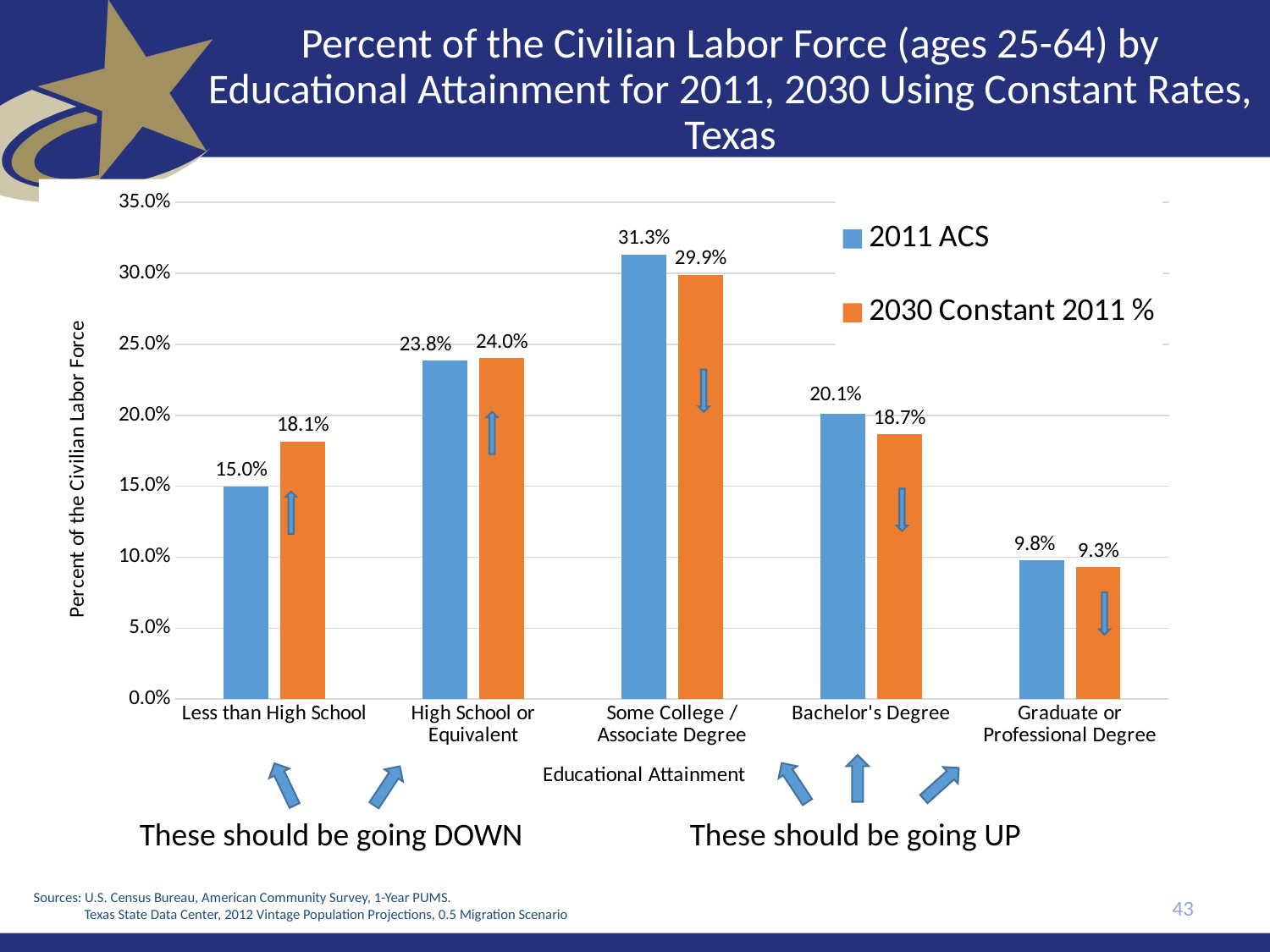
Is the 2011 ACS value for High School or Equivalent greater or less than 25.0%? less For Bachelor's Degree, which is larger: the 2011 ACS value or the 2030 Constant 2011 % value? 2011 ACS What is the 2030 Constant 2011 % value for Graduate or Professional Degree? 9.3% What is the 2030 Constant 2011 % value for Bachelor's Degree? 18.7% How many educational attainment categories are shown on the x axis? 5 Which educational attainment category has the highest 2011 ACS value? Some College / Associate Degree What is the difference between the 2030 Constant 2011 % and 2011 ACS values for Less than High School? 3.1% What is the 2011 ACS value for Some College / Associate Degree? 31.3% What kind of chart is shown on the slide? bar chart Which educational attainment category has the lowest 2030 Constant 2011 % value? Graduate or Professional Degree How many series does the legend list? 2 What is the 2011 ACS value for Less than High School? 15.0%